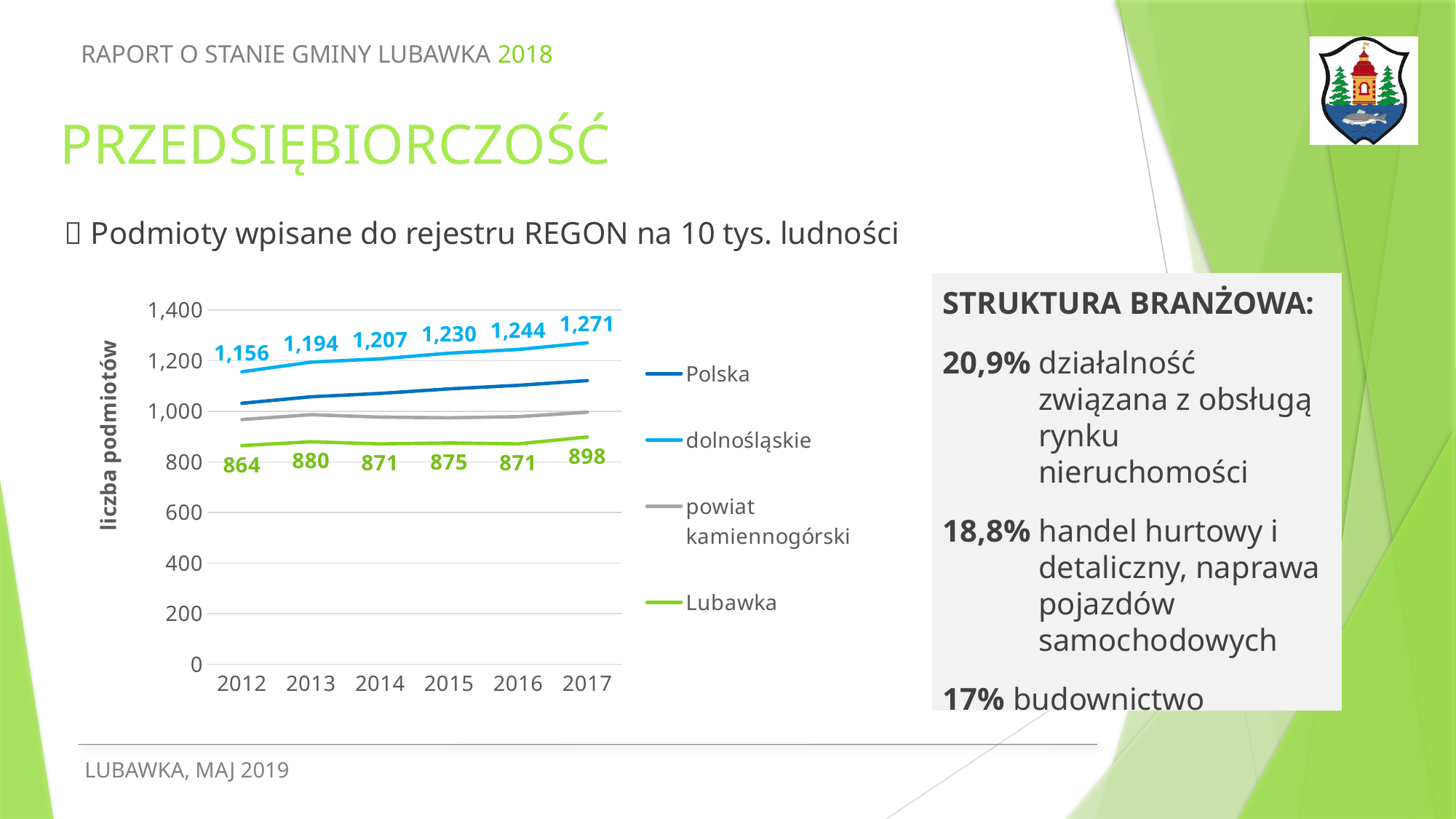
What is the difference between the Lubawka values in 2017 and 2016? 27 What is the value for dolnośląskie in 2017? 1,271 In which year is the Lubawka series highest? 2017 What kind of chart is shown on the slide? line chart Which series has the higher value in 2014, Polska or Lubawka? Polska How many series does the legend list? 4 Is the value for Polska in 2017 greater or less than 1,000? greater What is the difference between the dolnośląskie value in 2017 and in 2012? 115 What is the value for Lubawka in 2015? 875 How many years are shown on the x axis? 6 In which year is the dolnośląskie series lowest? 2012 What is the value for Lubawka in 2012? 864